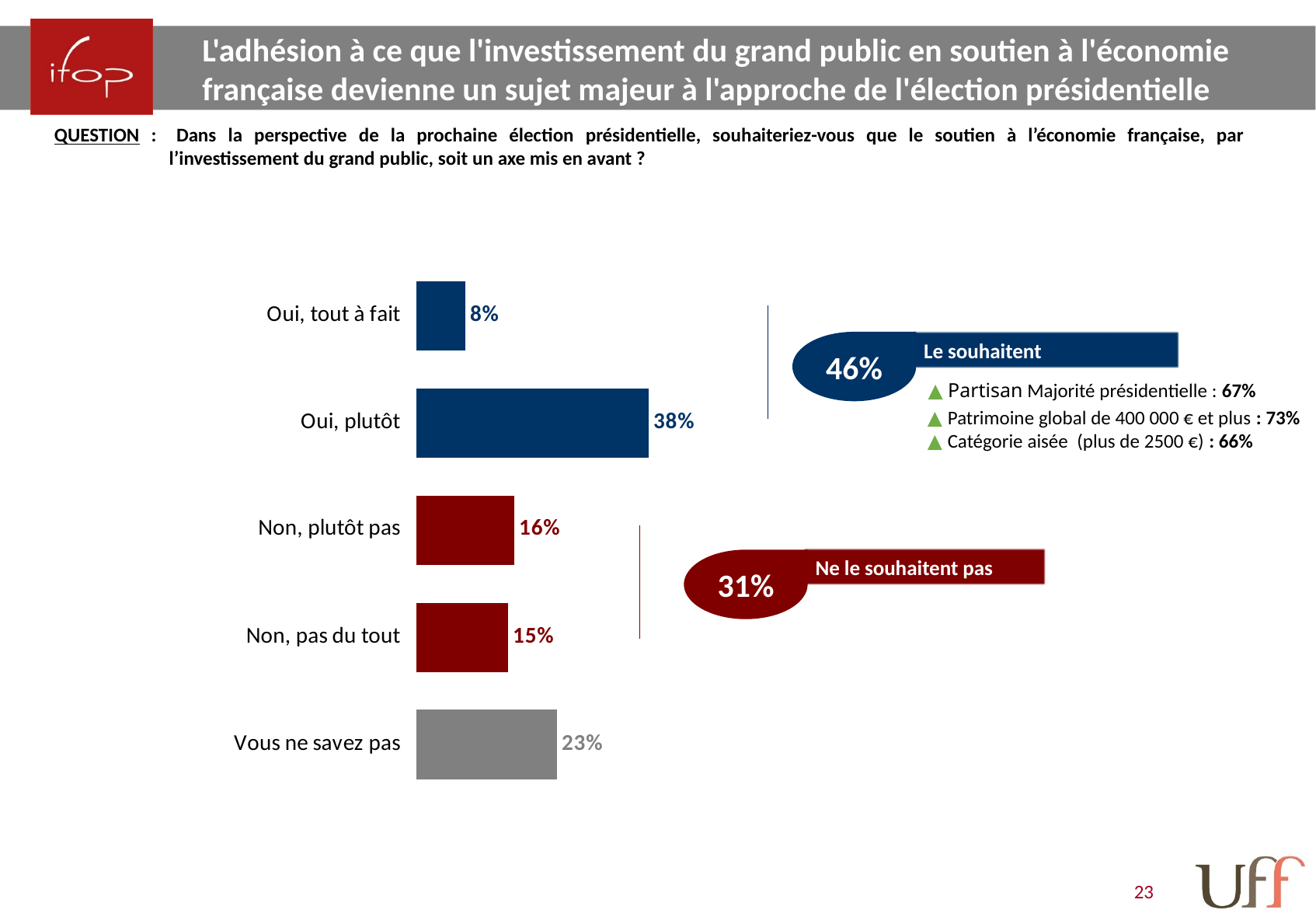
Which is larger, "Non, plutôt pas" or "Non, pas du tout"? Non, plutôt pas What kind of chart is shown on the slide? Bar chart What is the value for "Oui, plutôt"? 38% What is the combined percentage shown for "Ne le souhaitent pas"? 31% Which category has the lowest value? Oui, tout à fait What is the combined percentage shown for "Le souhaitent"? 46% What is the value for "Vous ne savez pas"? 23% How many categories are shown in the chart? 5 What is the value for "Non, plutôt pas"? 16% Which category has the highest value? Oui, plutôt What is the value for "Oui, tout à fait"? 8% What is the difference between "Oui, plutôt" and "Vous ne savez pas"? 15%